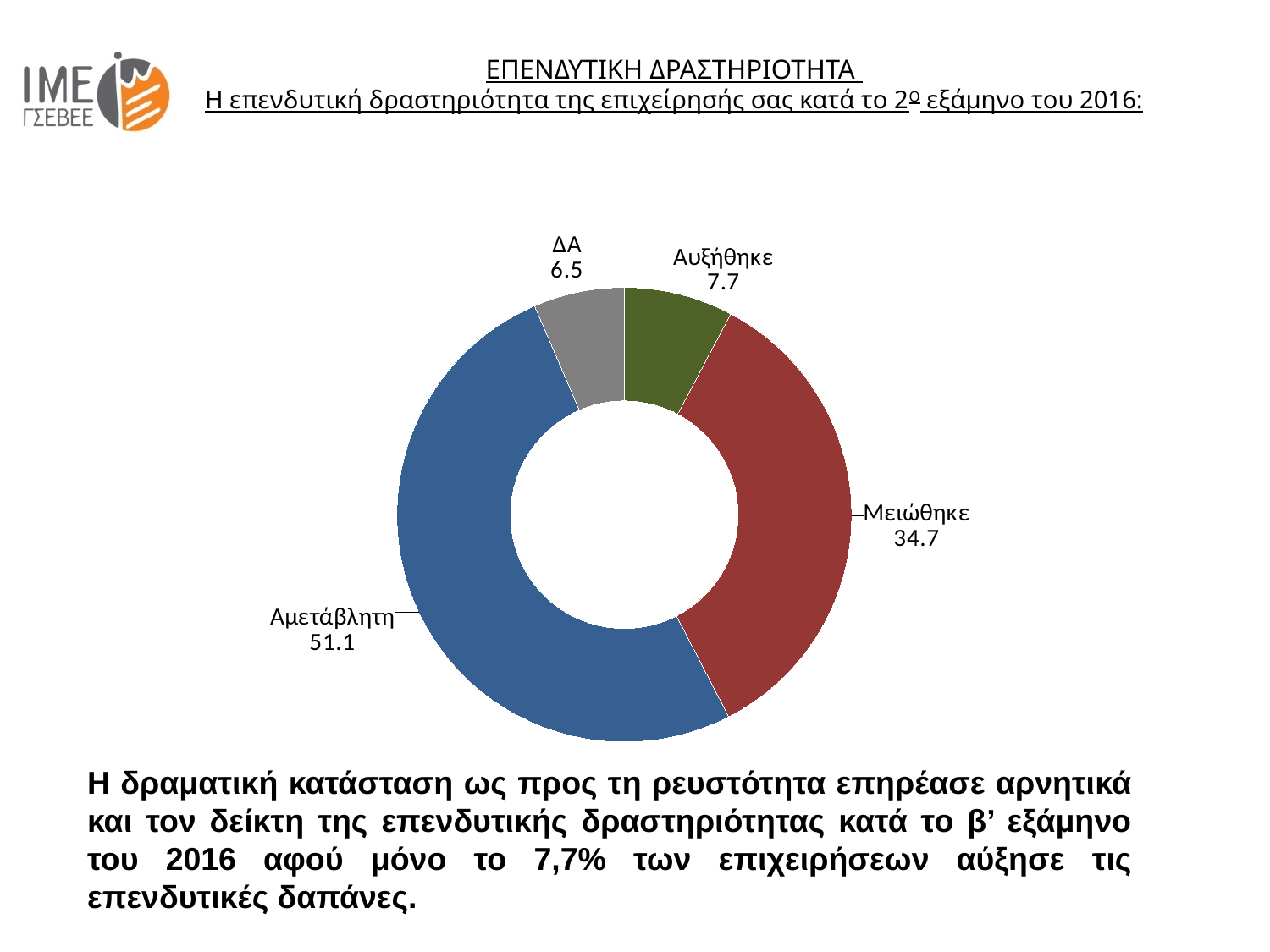
Which category has the smallest share of the chart? ΔΑ How many categories are shown in the chart? 4 What value is shown for Μειώθηκε? 34.7 What is the difference between the values for Αμετάβλητη and Μειώθηκε? 16.4 What value is shown for Αυξήθηκε? 7.7 Which is larger, the value for Μειώθηκε or the value for Αυξήθηκε? Μειώθηκε What colour is the Αμετάβλητη slice? Blue What value is shown for ΔΑ? 6.5 Which category has the largest share of the chart? Αμετάβλητη What kind of chart is shown on the slide? Doughnut (pie) chart What value is shown for Αμετάβλητη? 51.1 What is the difference between the values for Αυξήθηκε and ΔΑ? 1.2